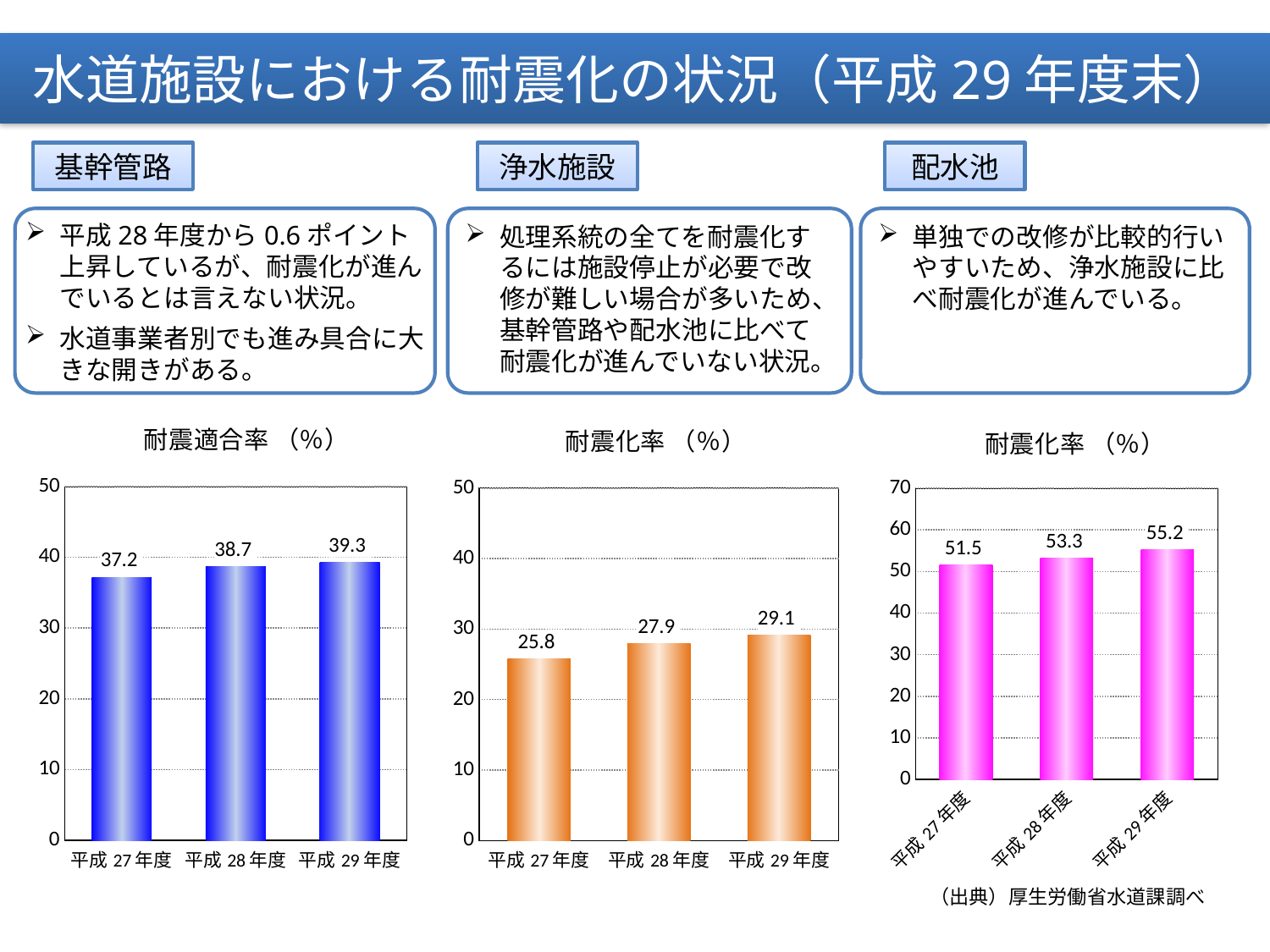
In the right chart, what is the difference between the values for 平成29年度 and 平成27年度? 3.7 In the right chart (耐震化率), what is the value for 平成28年度? 53.3 In the left chart (耐震適合率), what is the value for 平成29年度? 39.3 In the middle chart (耐震化率), what is the value for 平成27年度? 25.8 How many bars are plotted in the left chart? 3 In the left chart, what is the difference between the values for 平成29年度 and 平成28年度? 0.6 What kind of chart is the middle chart? bar chart In the middle chart, which is larger: the value for 平成28年度 or 平成29年度? 平成29年度 In the middle chart, do the values rise or fall from 平成27年度 to 平成29年度? rise In the middle chart, which year has the lowest value? 平成27年度 In the right chart, is the value for 平成27年度 greater or less than 50? greater In the right chart, which year has the highest value? 平成29年度